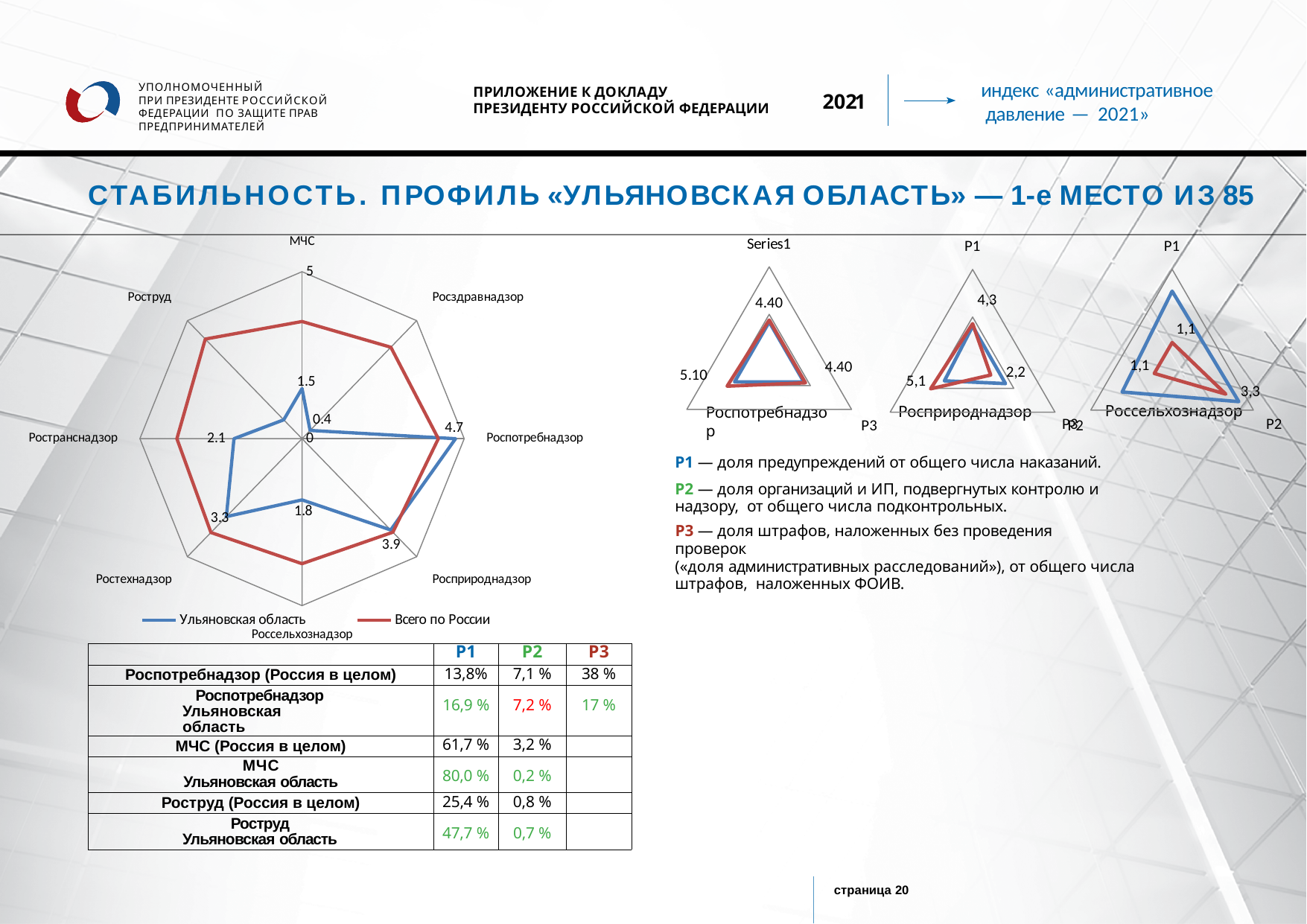
In the large radar chart on the left, at which category does Ульяновская область have its highest value? Роспотребнадзор In the large radar chart on the left, what is the value for Ульяновская область at МЧС? 1.5 In the large radar chart on the left, which is larger for Ульяновская область: the value at Ростехнадзор or at Ространснадзор? Ростехнадзор In the large radar chart on the left, which series is drawn in red? Всего по России In the large radar chart on the left, what is the value for Ульяновская область at Роспотребнадзор? 4.7 In the large radar chart on the left, what is the difference between the Ульяновская область values at Роспотребнадзор and Росприроднадзор? 0.8 What kind of chart is the large chart on the left of the slide? radar chart In the small radar chart titled Росприроднадзор on the right, how many axes are plotted? 3 In the large radar chart on the left, how many categories (axes) are plotted? 8 In the large radar chart on the left, what is the value for Ульяновская область at Ростехнадзор? 3.3 In the large radar chart on the left, what is the value for Ульяновская область at Росприроднадзор? 3.9 In the large radar chart on the left, how many series does the legend list? 2